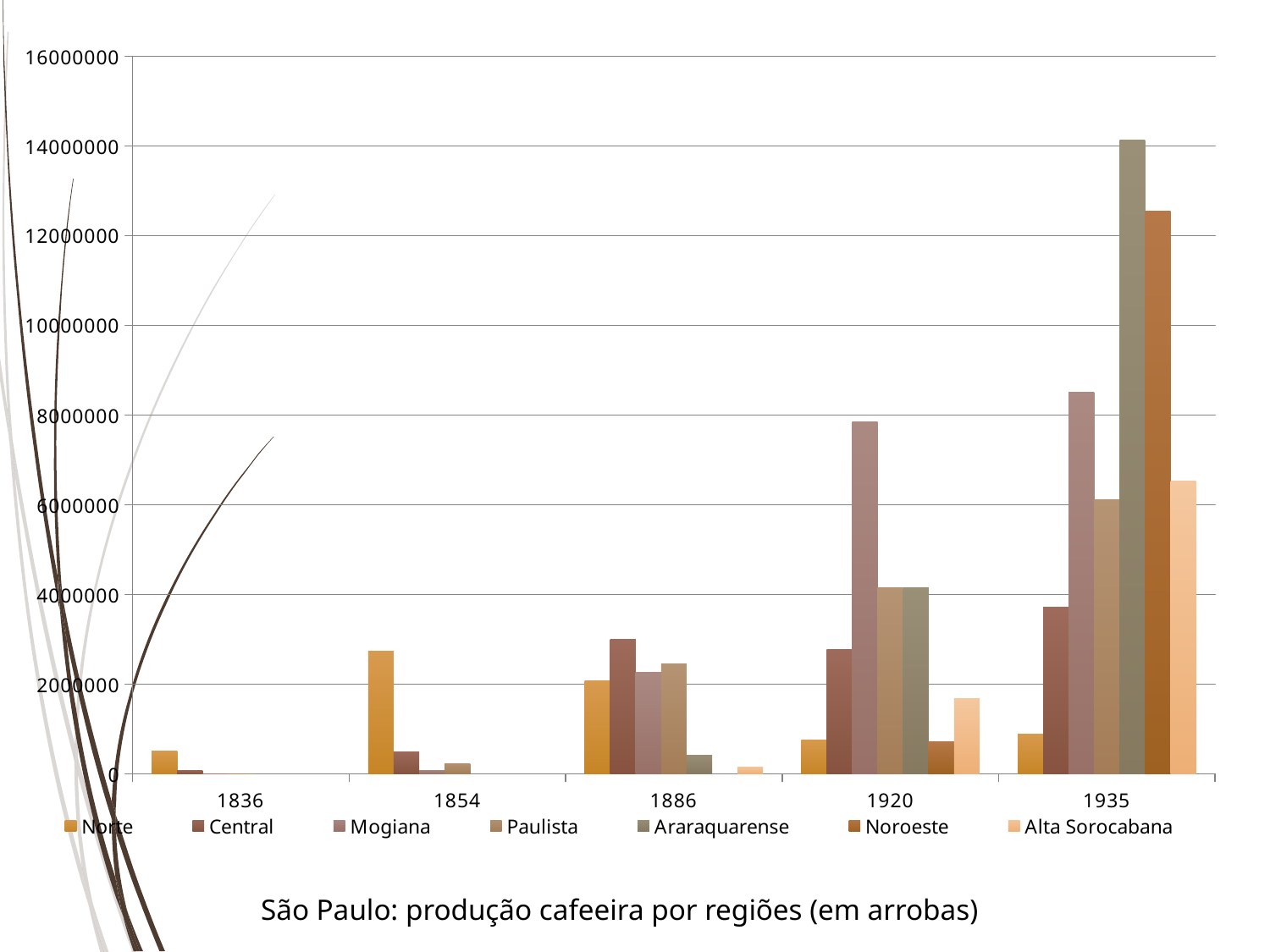
How many year categories are shown on the x axis? 5 Which region has the highest bar in 1935? Araraquarense Which region has the highest bar in 1920? Mogiana Which region has the lowest bar in 1935? Norte What kind of chart is shown on the slide? bar chart Is the value for Noroeste in 1935 greater or less than 12000000? greater Is the value for Norte in 1854 greater or less than 2000000? greater In 1935, which is larger: the value for Araraquarense or the value for Noroeste? Araraquarense How many series does the legend list? 7 Does the value for Araraquarense rise or fall from 1886 to 1935? rise In 1920, which is larger: the value for Mogiana or the value for Paulista? Mogiana What is the title of the chart? São Paulo: produção cafeeira por regiões (em arrobas)